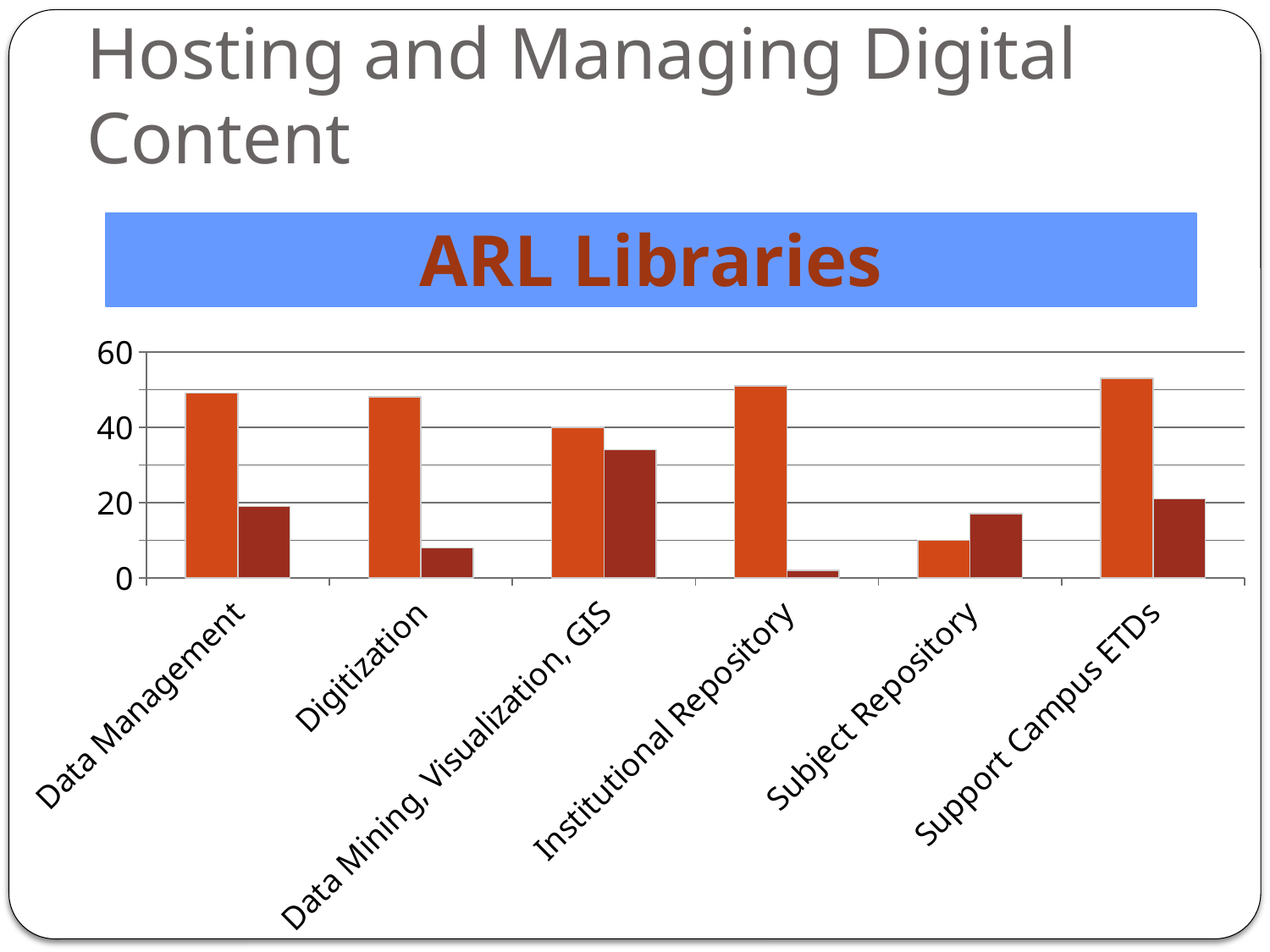
What kind of chart is shown on the slide? bar chart How many categories are shown on the x axis of the chart? 6 For Subject Repository, which bar is taller, the orange (left) bar or the dark red (right) bar? dark red (right) bar Is the orange (left) bar for Data Management greater or less than 40? greater Is the orange (left) bar for Subject Repository greater or less than 20? less What is the title shown above the chart? ARL Libraries Is the dark red (right) bar for Data Mining, Visualization, GIS greater or less than 20? greater Which category has the lowest orange (left) bar? Subject Repository What is the highest value labelled on the vertical axis of the chart? 60 Which category has the highest dark red (right) bar? Data Mining, Visualization, GIS